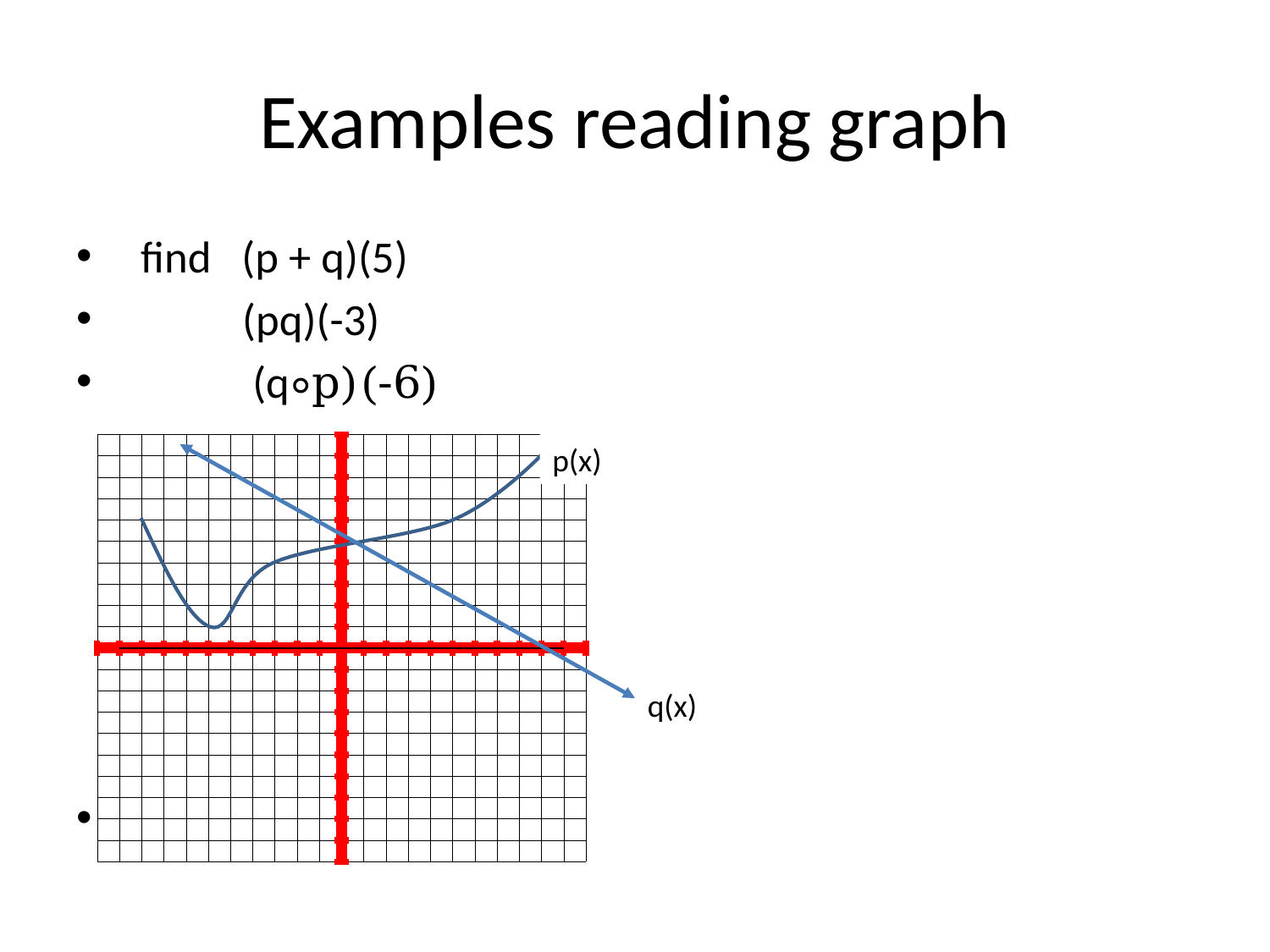
How many functions are plotted on the graph? 2 What is the title of the slide containing the graph? Examples reading graph Does q(x) rise or fall as x increases? fall Does p(x) rise or fall on the right-hand side of the graph as x increases? rise What are the labels of the two functions plotted on the graph? p(x) and q(x) What colour are the axes drawn on the graph? red Which function has a higher value at the far left edge of the grid, p(x) or q(x)? q(x) Which function has a higher value at the far right edge of the grid, p(x) or q(x)? p(x)